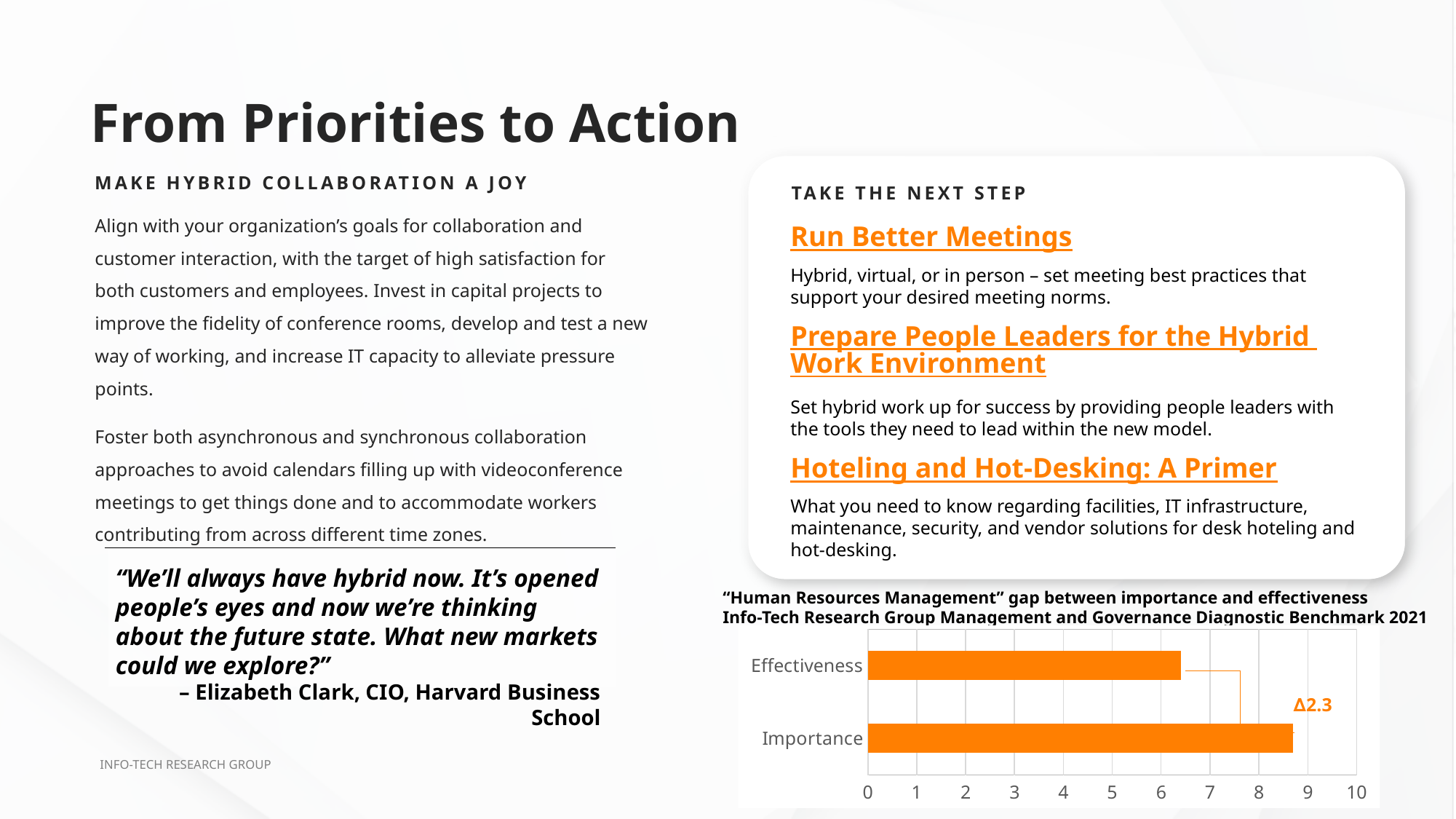
Is the value for Effectiveness greater or less than 6? greater What is the highest tick value shown on the x axis of the bar chart? 10 Which is larger in the bar chart, Importance or Effectiveness? Importance Is the value for Effectiveness greater or less than 7? less How many categories are plotted in the bar chart? 2 Is the value for Importance greater or less than 8? greater What gap between Importance and Effectiveness is labelled on the bar chart? Δ2.3 What colour are the bars in the chart? orange Which category has the highest value in the bar chart? Importance What kind of chart is shown at the bottom right of the slide? bar chart Which category has the lowest value in the bar chart? Effectiveness